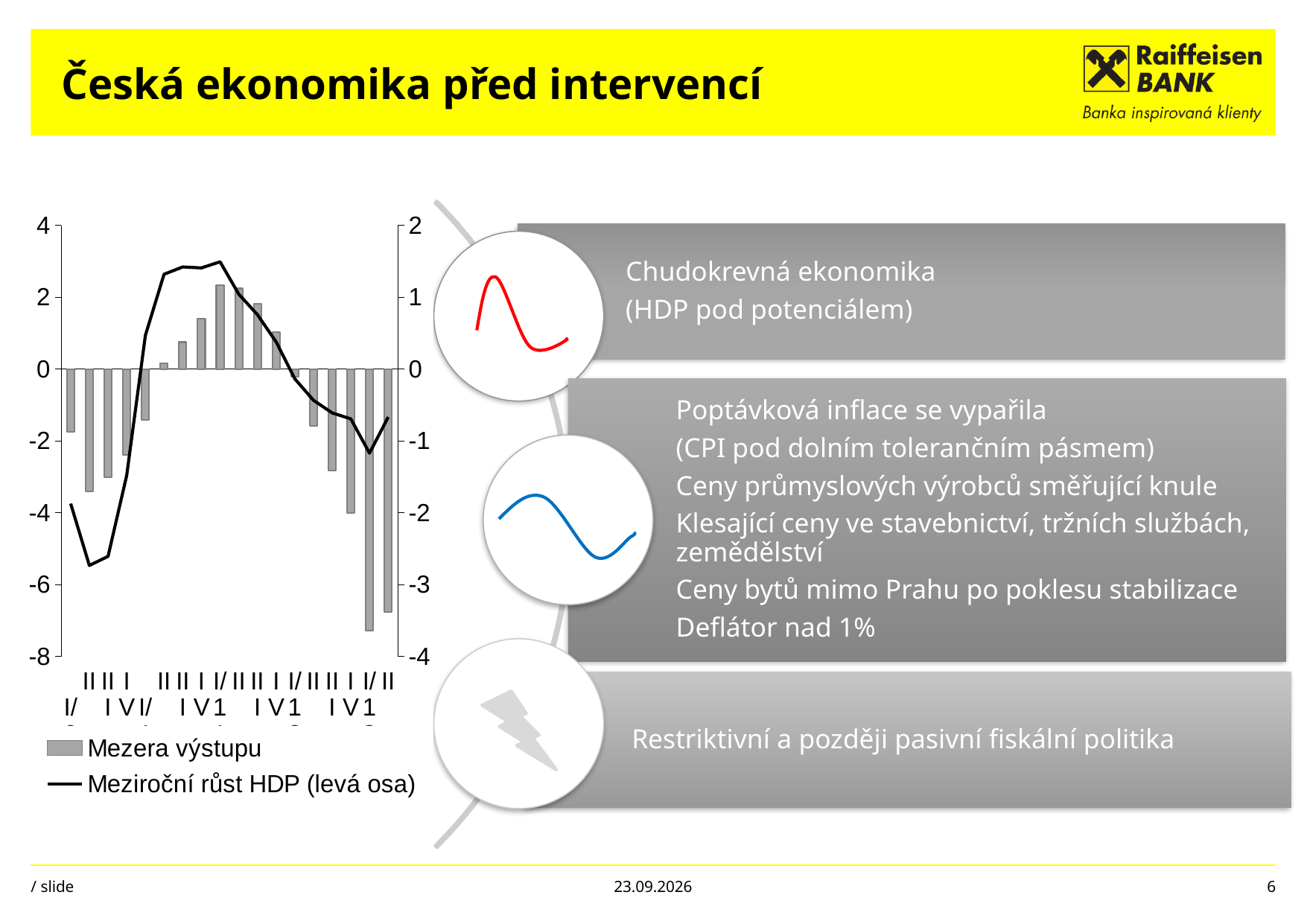
Which series does the legend say is plotted on the left axis? Meziroční růst HDP How many series does the chart legend list? 2 Is the highest point of the Meziroční růst HDP line greater or less than 2 on the left axis? greater Does the Meziroční růst HDP line rise or fall between its first point and its peak? rise How many Mezera výstupu bars are plotted in the chart? 18 What kind of chart is shown on the slide? A combined bar and line chart Is the lowest Mezera výstupu bar greater or less than -3 on the right axis? less Which series is plotted as bars in the chart? Mezera výstupu Is the tallest positive Mezera výstupu bar greater or less than 1 on the right axis? greater